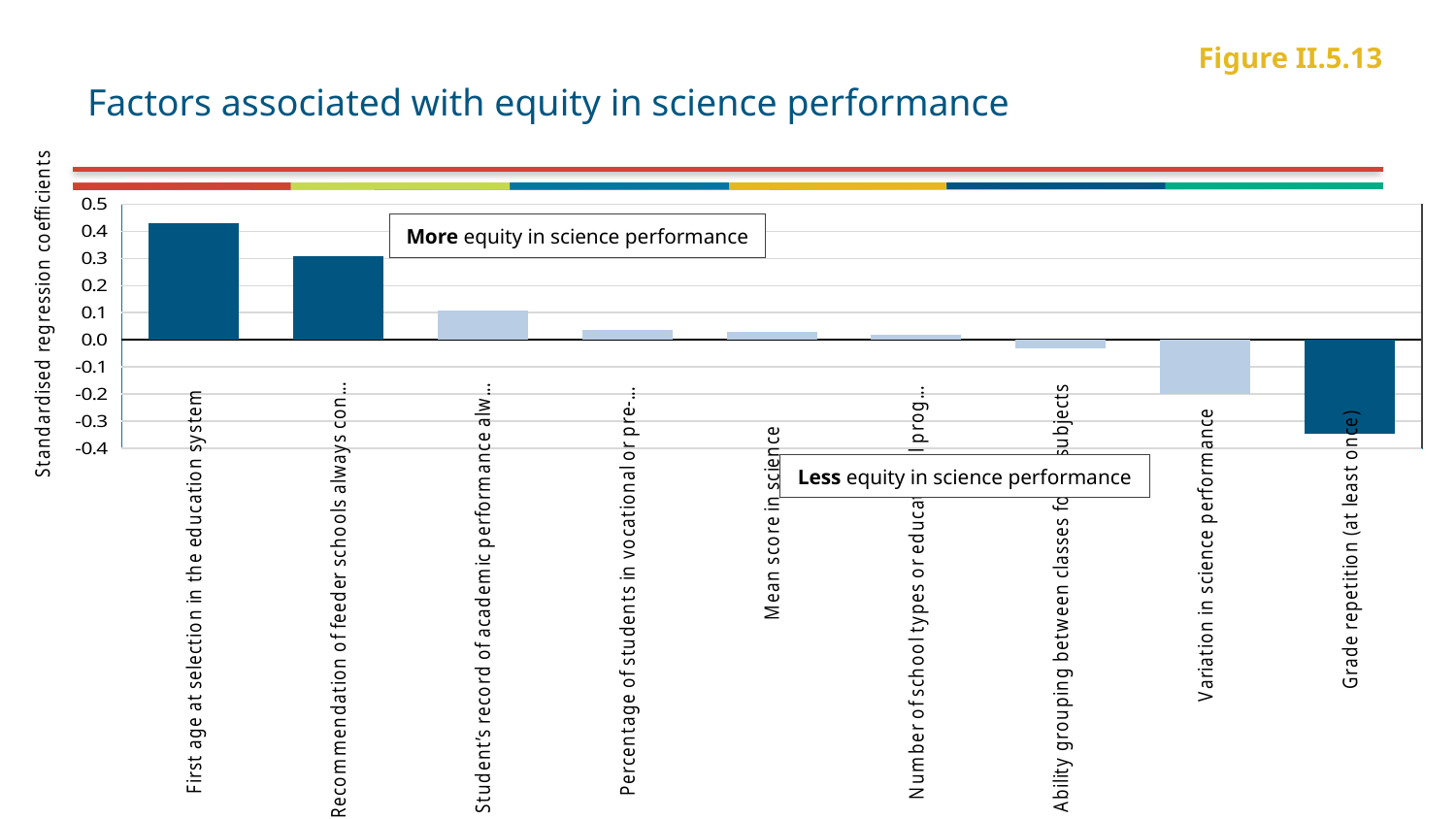
What kind of chart is shown on the slide? Bar chart Is the coefficient for 'Variation in science performance' greater or less than -0.1? less How many bars in the chart have negative coefficients? 3 What is the title of the chart? Factors associated with equity in science performance Is the coefficient for 'Grade repetition (at least once)' greater or less than -0.3? less Is the coefficient for 'First age at selection in the education system' greater or less than 0.4? greater What is the label on the vertical axis of the chart? Standardised regression coefficients Which factor has the lowest standardised regression coefficient? Grade repetition (at least once) Which has the larger coefficient: 'First age at selection in the education system' or 'Recommendation of feeder schools'? First age at selection in the education system How many factors (bars) are plotted in the chart? 9 Which factor has the highest standardised regression coefficient? First age at selection in the education system